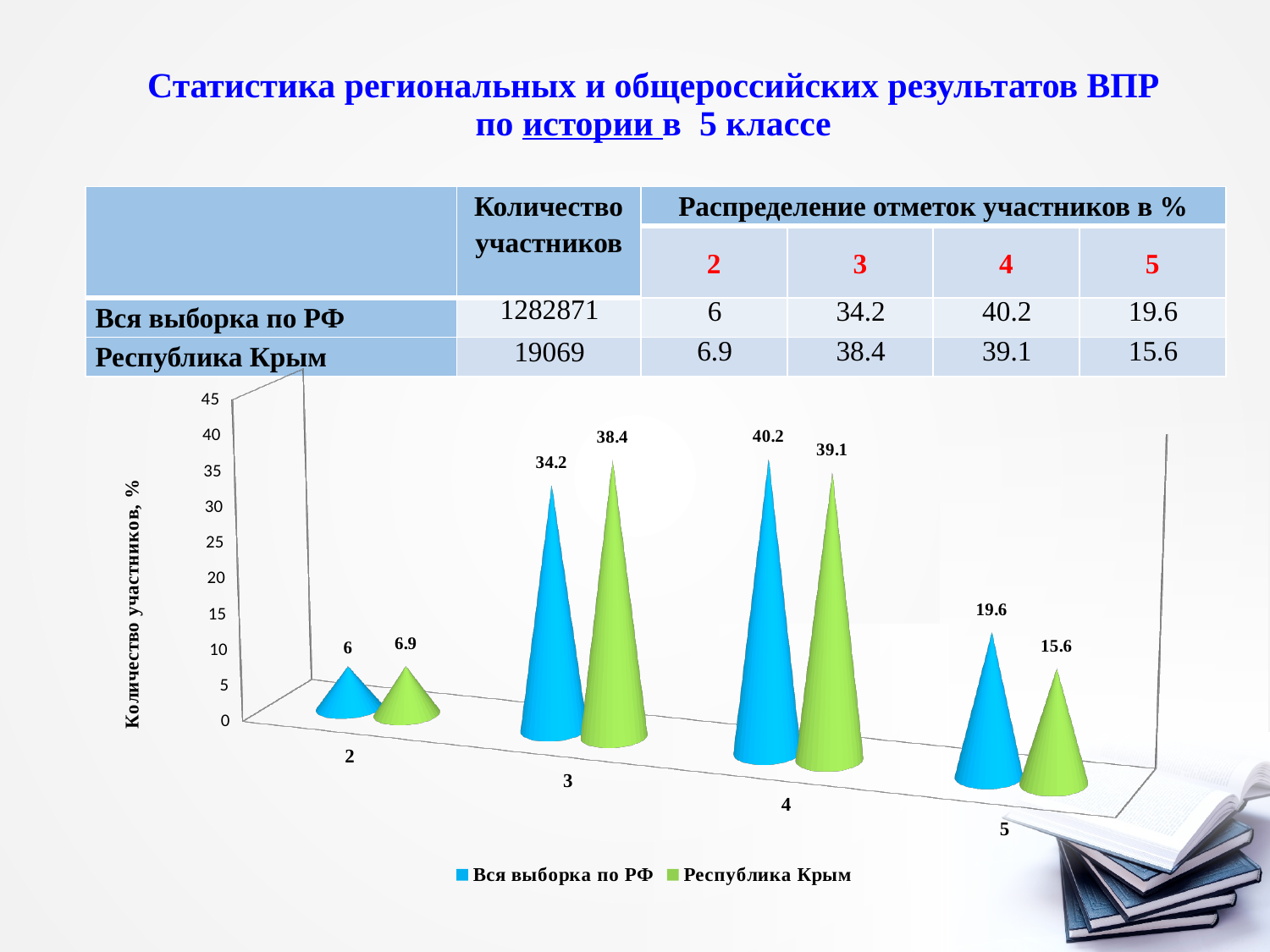
What is the value for "Вся выборка по РФ" at grade 4? 40.2 What is the difference between the "Вся выборка по РФ" and "Республика Крым" values at grade 5? 4 For which grade is the "Вся выборка по РФ" value highest? 4 For which grade is the "Республика Крым" value lowest? 2 What kind of chart is shown on the slide? bar chart At grade 3, which series has the larger value: "Вся выборка по РФ" or "Республика Крым"? Республика Крым What is the value for "Республика Крым" at grade 3? 38.4 How many series does the chart legend list? 2 What is the value for "Республика Крым" at grade 5? 15.6 What is the label of the vertical axis of the chart? Количество участников, % What is the value for "Вся выборка по РФ" at grade 2? 6 How many grade categories are shown on the x axis of the chart? 4